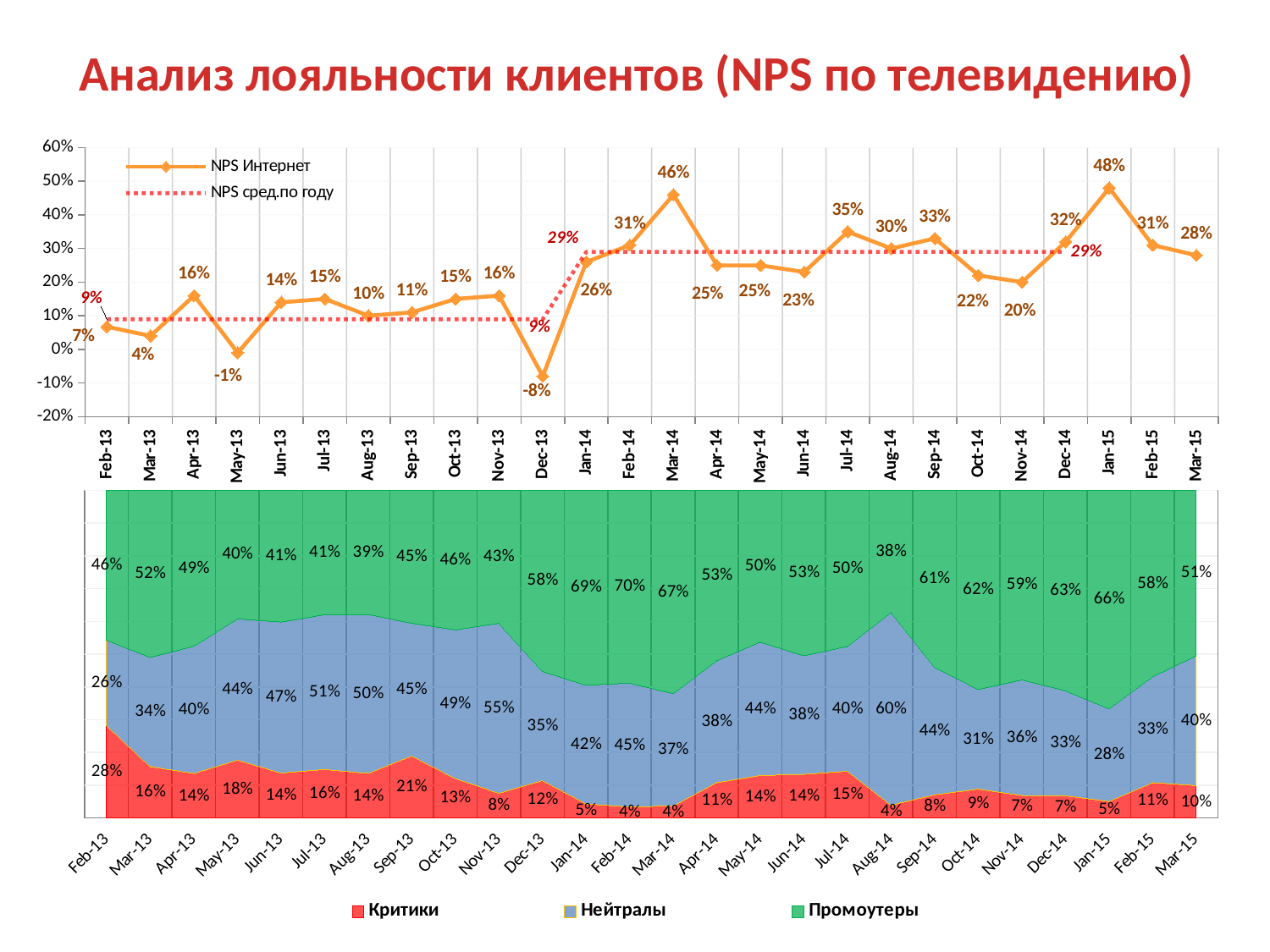
What type of chart is the top chart on the slide? Line chart In the bottom stacked area chart, what is the total of Критики, Нейтралы and Промоутеры for Mar-15? 101% In the top line chart, what is the NPS Интернет value for Mar-14? 46% How many series does the legend of the bottom stacked area chart list? 3 How many series does the legend of the top line chart list? 2 In the bottom stacked area chart, which is larger for Aug-14: Нейтралы or Промоутеры? Нейтралы In the top line chart, which month has the lowest NPS Интернет value? Dec-13 In the top line chart, which month has the highest NPS Интернет value? Jan-15 In the bottom stacked area chart, what is the Промоутеры share for Feb-14? 70% In the top line chart, what is the difference between the NPS Интернет values for Jan-15 and Mar-15? 20% In the bottom stacked area chart, what is the Критики share for Sep-13? 21% In the top line chart, what is the NPS сред.по году value shown for 2014? 29%